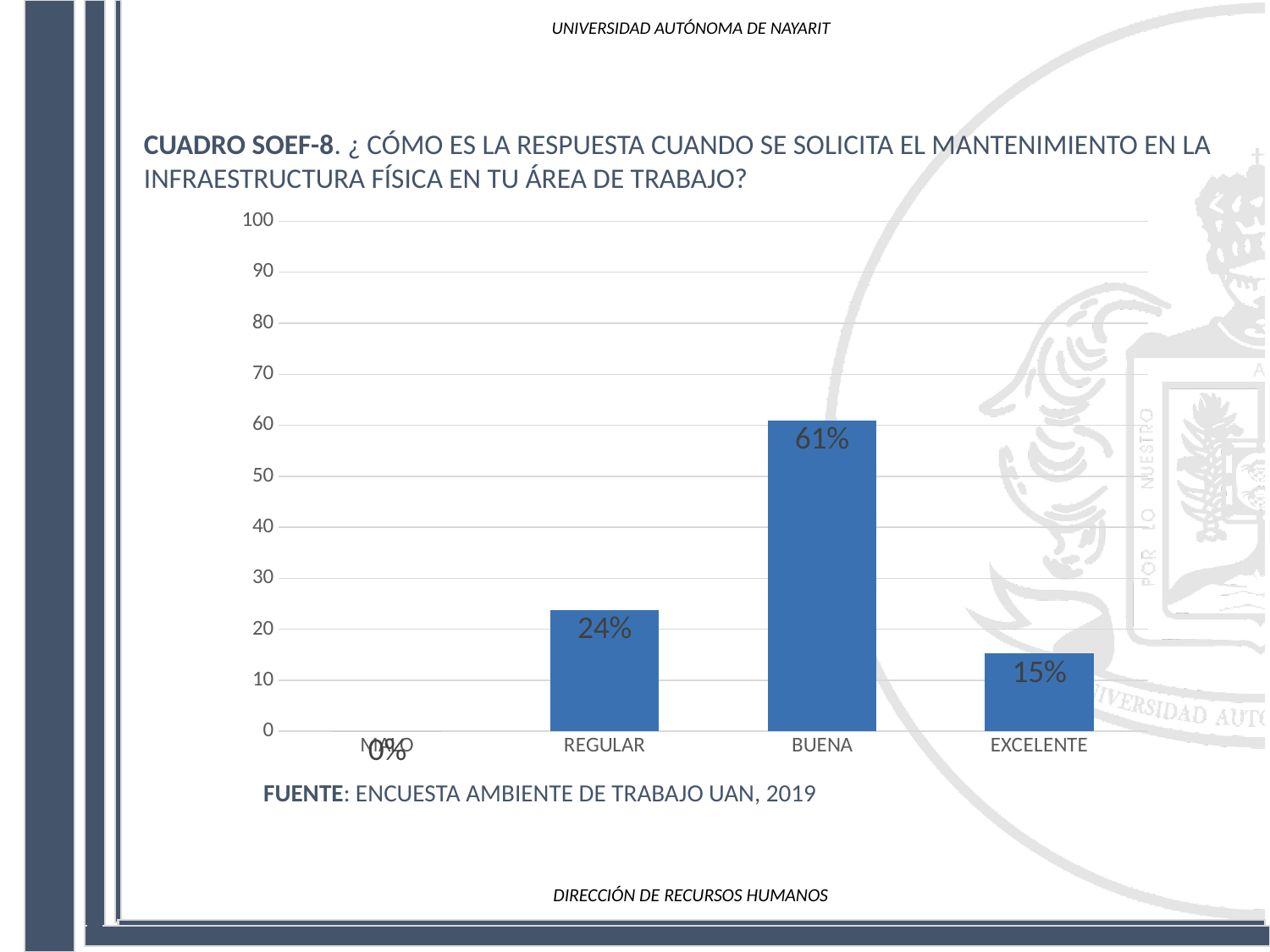
What is the value for REGULAR? 24% What is the value for BUENA? 61% Is the value for BUENA greater or less than 50? greater What value is shown for the leftmost category? 0% What is the difference between the values for REGULAR and EXCELENTE? 9% Which category has the highest value? BUENA What is the value for EXCELENTE? 15% What is the difference between the values for BUENA and REGULAR? 37% Which is larger, the value for REGULAR or the value for EXCELENTE? REGULAR How many categories are shown on the x axis? 4 What kind of chart is shown on the slide? bar chart Which of the three labelled bars with non-zero values is the lowest? EXCELENTE